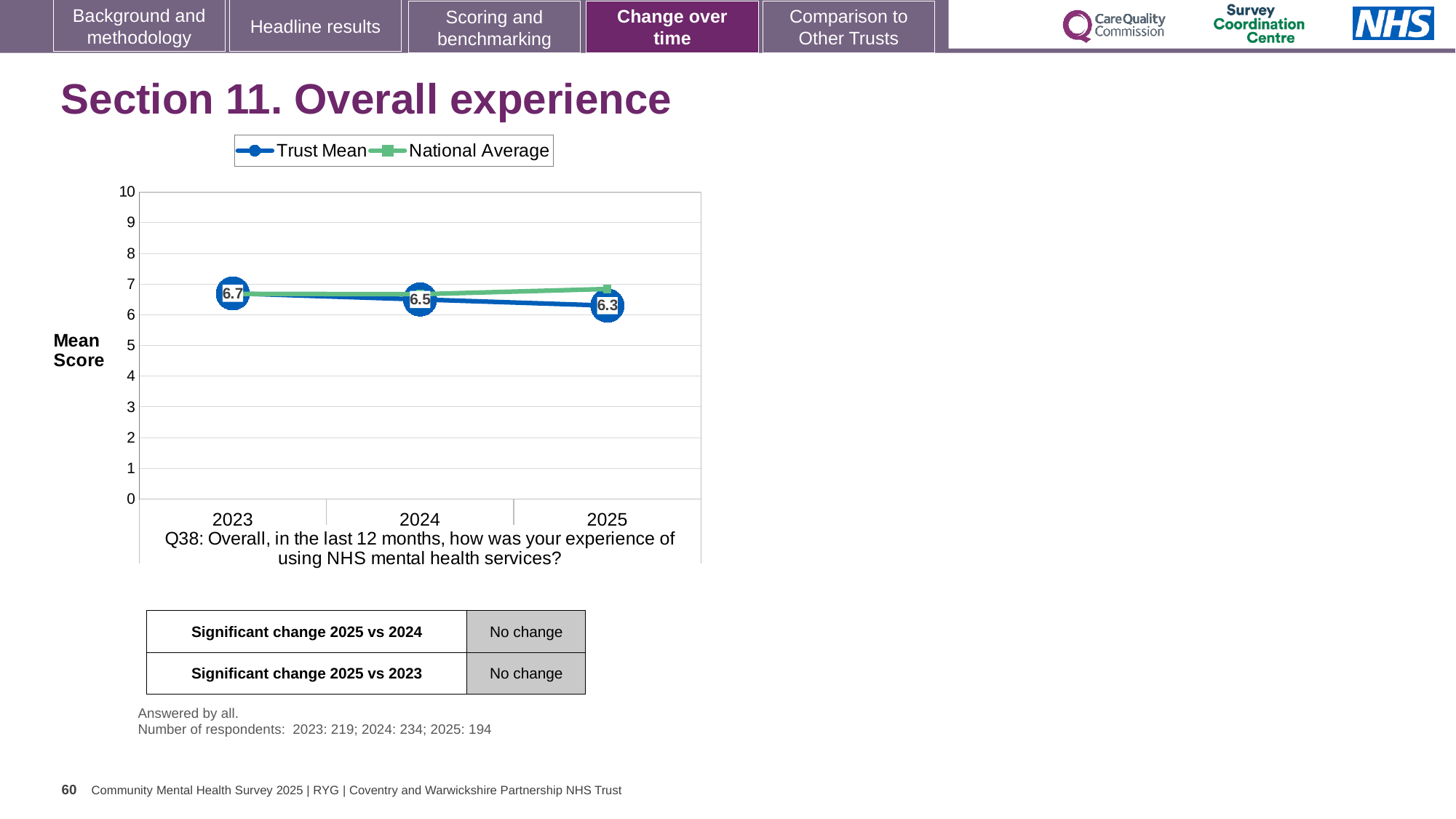
Which is larger, the Trust Mean score for 2023 or for 2025? 2023 How many series does the chart legend list? 2 How many years are plotted on the x axis of the chart? 3 What kind of chart is shown on the slide? Line chart Does the Trust Mean score rise or fall from 2023 to 2025? Fall What is the Trust Mean score for 2024? 6.5 In which year is the Trust Mean score lowest? 2025 In which year is the Trust Mean score highest? 2023 What is the Trust Mean score for 2023? 6.7 What is the difference between the Trust Mean score in 2023 and in 2025? 0.4 What is the Trust Mean score for 2025? 6.3 Is the National Average value for 2025 greater or less than 5? greater